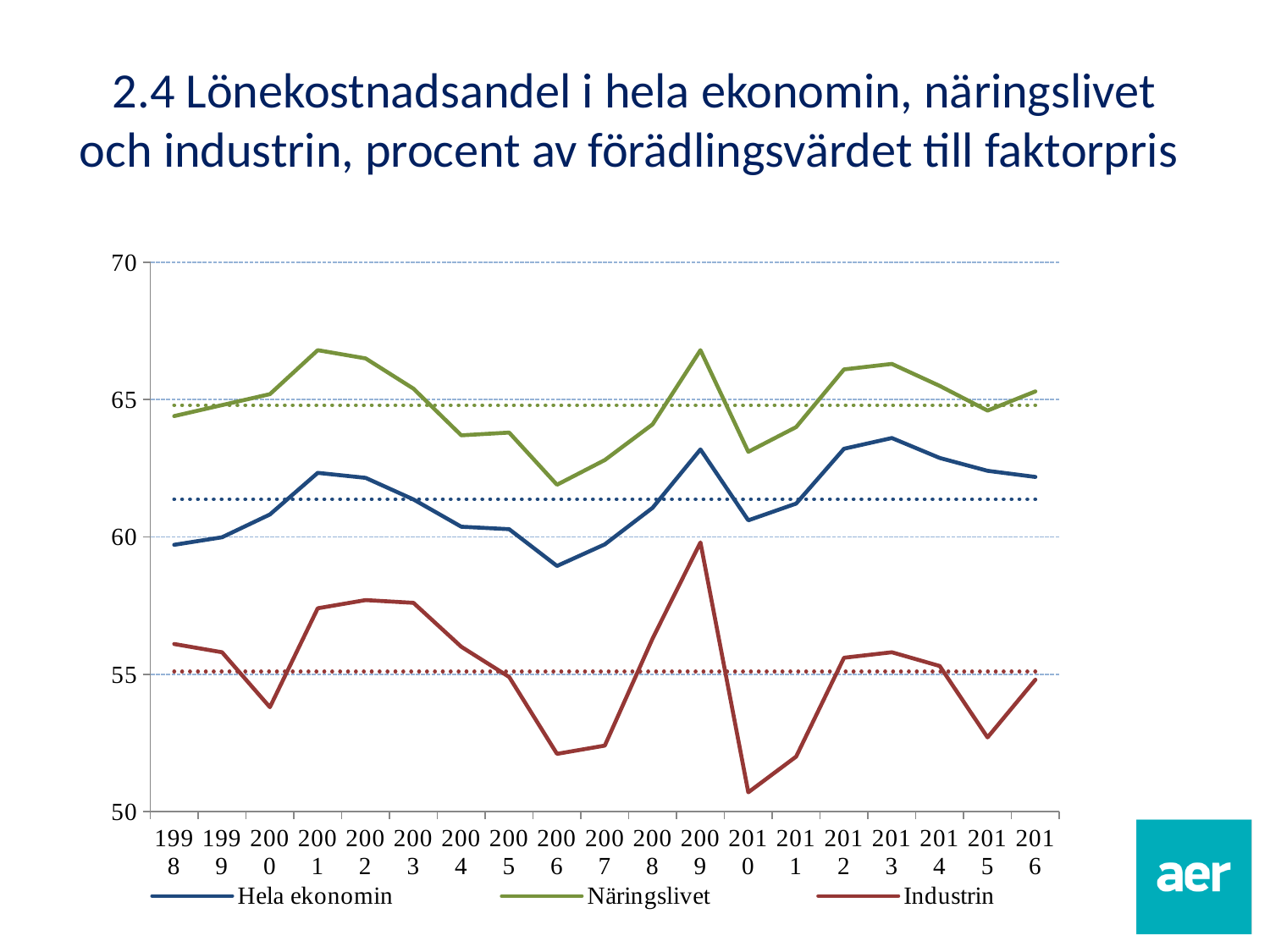
Is the value for Industrin in 2010 greater or less than 55? less In which year does the Industrin series reach its lowest value? 2010 Is the value for Näringslivet in 2001 greater or less than 65? greater Does the Industrin series rise or fall from 2009 to 2010? fall Is the value for Hela ekonomin in 2006 greater or less than 60? less What kind of chart is shown on the slide? line chart Which series is higher in 2009, Näringslivet or Industrin? Näringslivet How many years are shown on the x axis? 19 In which year does the Hela ekonomin series reach its lowest value? 2006 In which year does the Industrin series reach its highest value? 2009 How many series does the legend list? 3